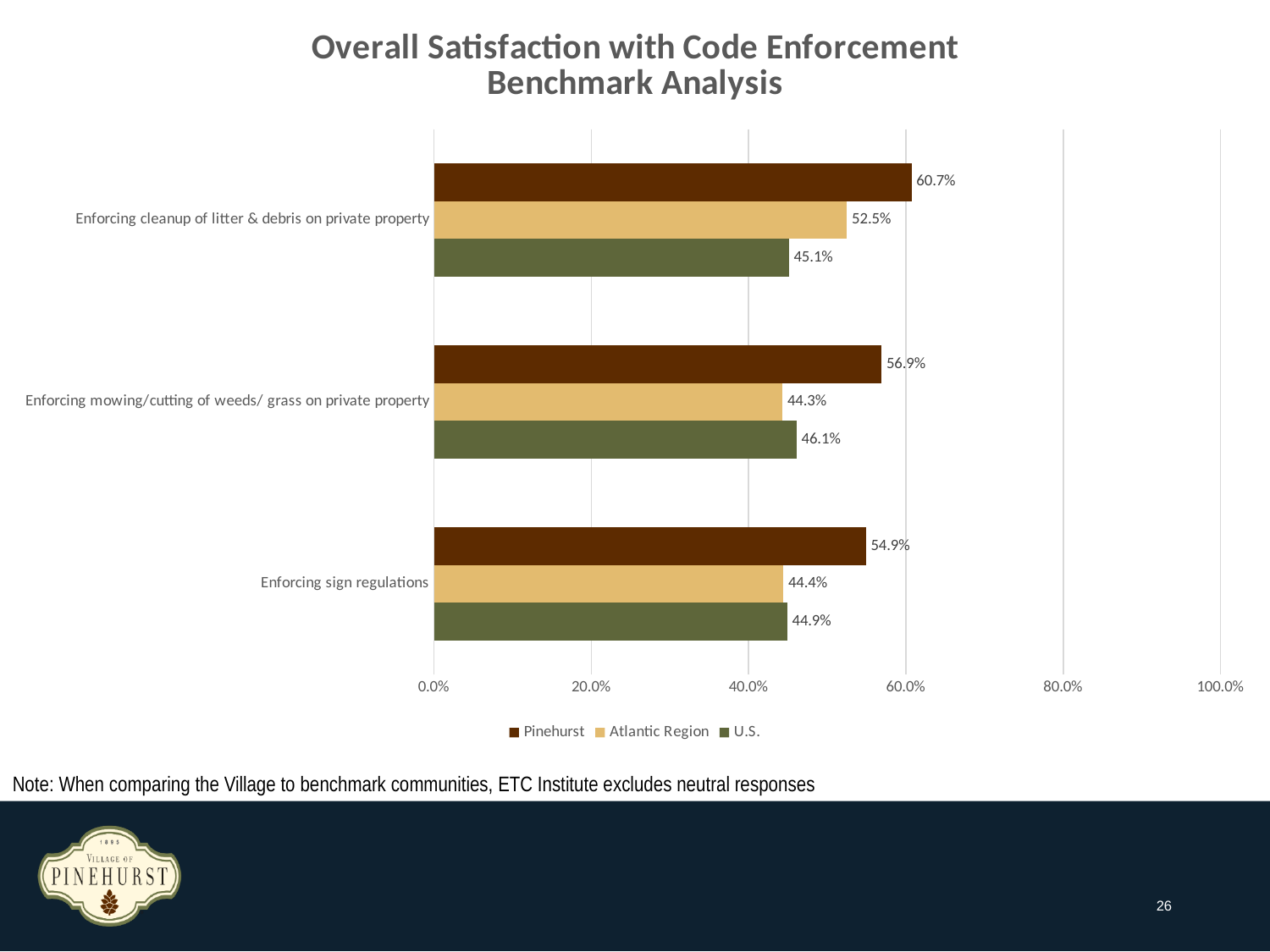
What is the difference between the Pinehurst and U.S. values for Enforcing cleanup of litter & debris on private property? 15.6% What is the Pinehurst value for Enforcing cleanup of litter & debris on private property? 60.7% What is the U.S. value for Enforcing sign regulations? 44.9% Which category has the highest Pinehurst value? Enforcing cleanup of litter & debris on private property Is the Pinehurst value for Enforcing cleanup of litter & debris on private property greater or less than 60.0%? greater How many categories are shown on the chart? 3 What is the Atlantic Region value for Enforcing mowing/cutting of weeds/ grass on private property? 44.3% What kind of chart is shown on the slide? Bar chart How many series does the legend list? 3 For Enforcing sign regulations, which is larger: the Pinehurst value or the Atlantic Region value? Pinehurst What is the title of the chart? Overall Satisfaction with Code Enforcement Benchmark Analysis Which category has the lowest Atlantic Region value? Enforcing mowing/cutting of weeds/ grass on private property